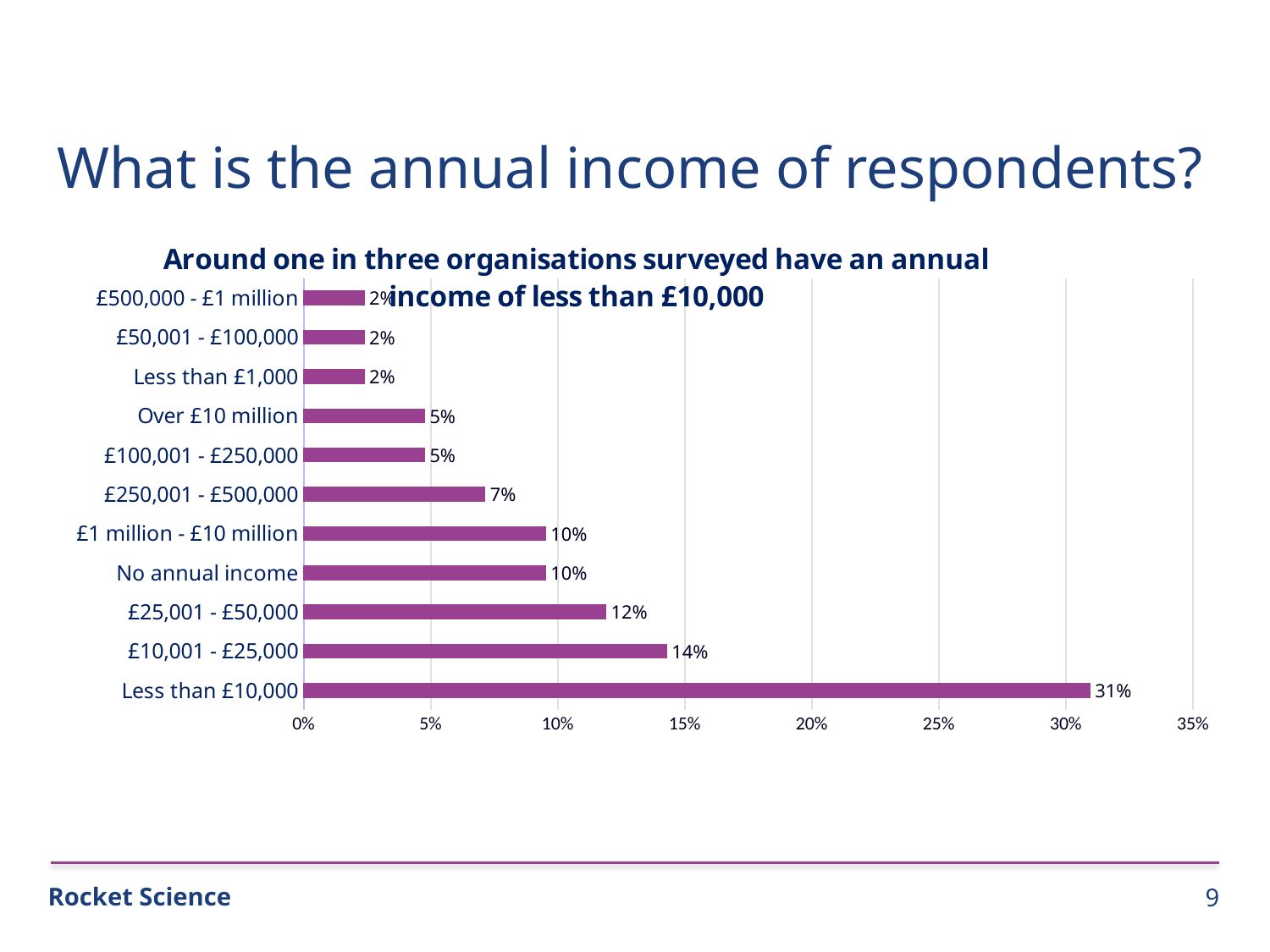
What percentage of respondents have an annual income of £10,001 - £25,000? 14% What percentage of respondents report no annual income? 10% How many income categories are shown in the chart? 11 Is the value for 'Less than £10,000' greater or less than 30%? greater What is the difference in percentage points between the 'Less than £10,000' and '£10,001 - £25,000' categories? 17% What is the difference in percentage points between the '£25,001 - £50,000' and '£100,001 - £250,000' categories? 7% What type of chart is shown on the slide? Bar chart Which has a larger share of respondents: '£25,001 - £50,000' or '£1 million - £10 million'? £25,001 - £50,000 What percentage of respondents have an annual income of less than £10,000? 31% What percentage of respondents have an annual income of £250,001 - £500,000? 7% Which income category has the highest percentage of respondents? Less than £10,000 What is the title of the chart? Around one in three organisations surveyed have an annual income of less than £10,000